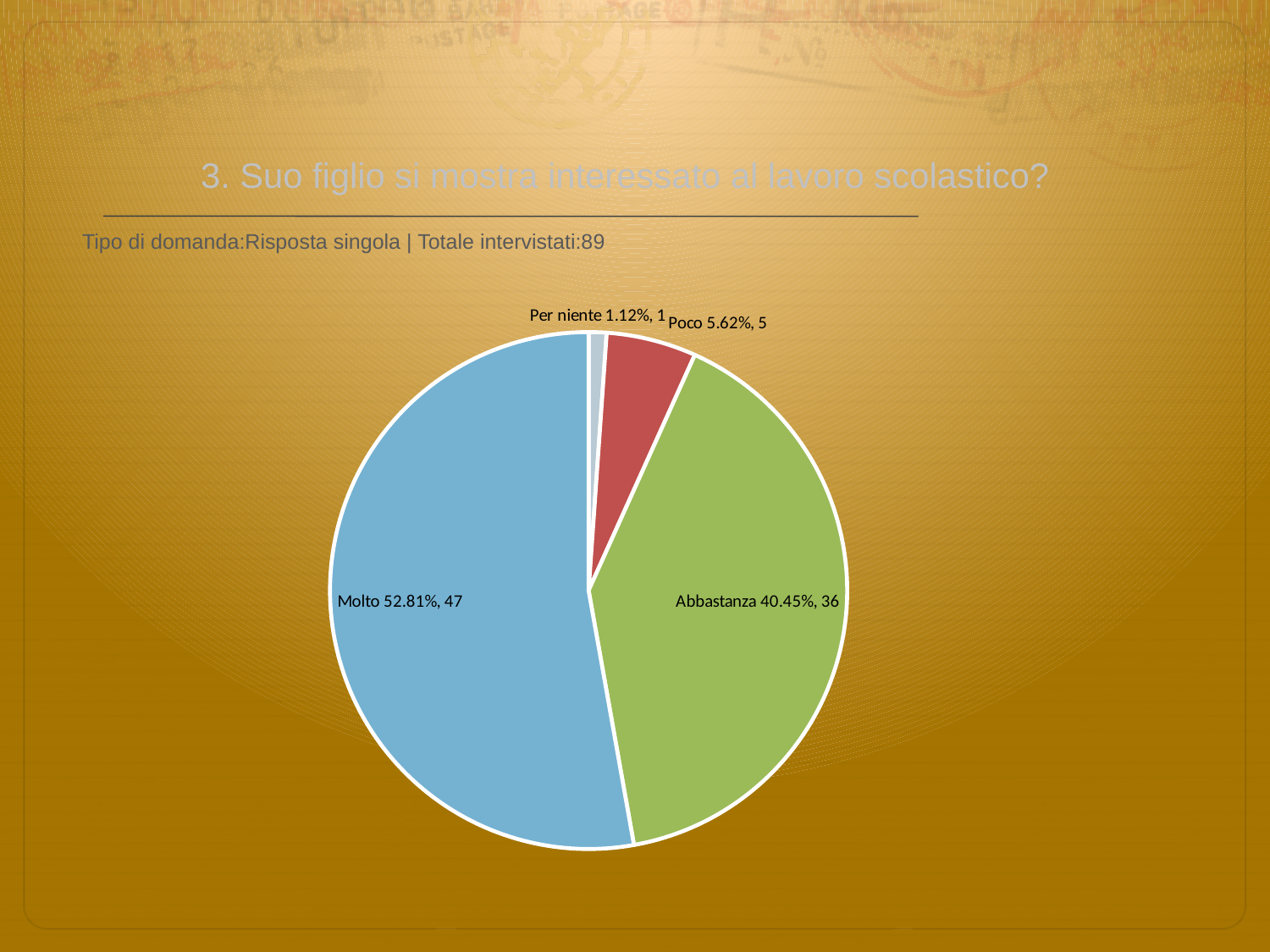
What colour is the Abbastanza slice? green What kind of chart is shown on the slide? pie chart How many respondents answered Per niente? 1 What is the total number of respondents across all slices? 89 Which has more respondents, Poco or Per niente? Poco What percentage share does the Abbastanza slice have? 40.45% Which category has the largest slice? Molto What percentage share does the Molto slice have? 52.81% How many respondents answered Poco? 5 What is the difference in respondent count between Molto and Abbastanza? 11 How many slices does the pie chart have? 4 Which category has the smallest slice? Per niente